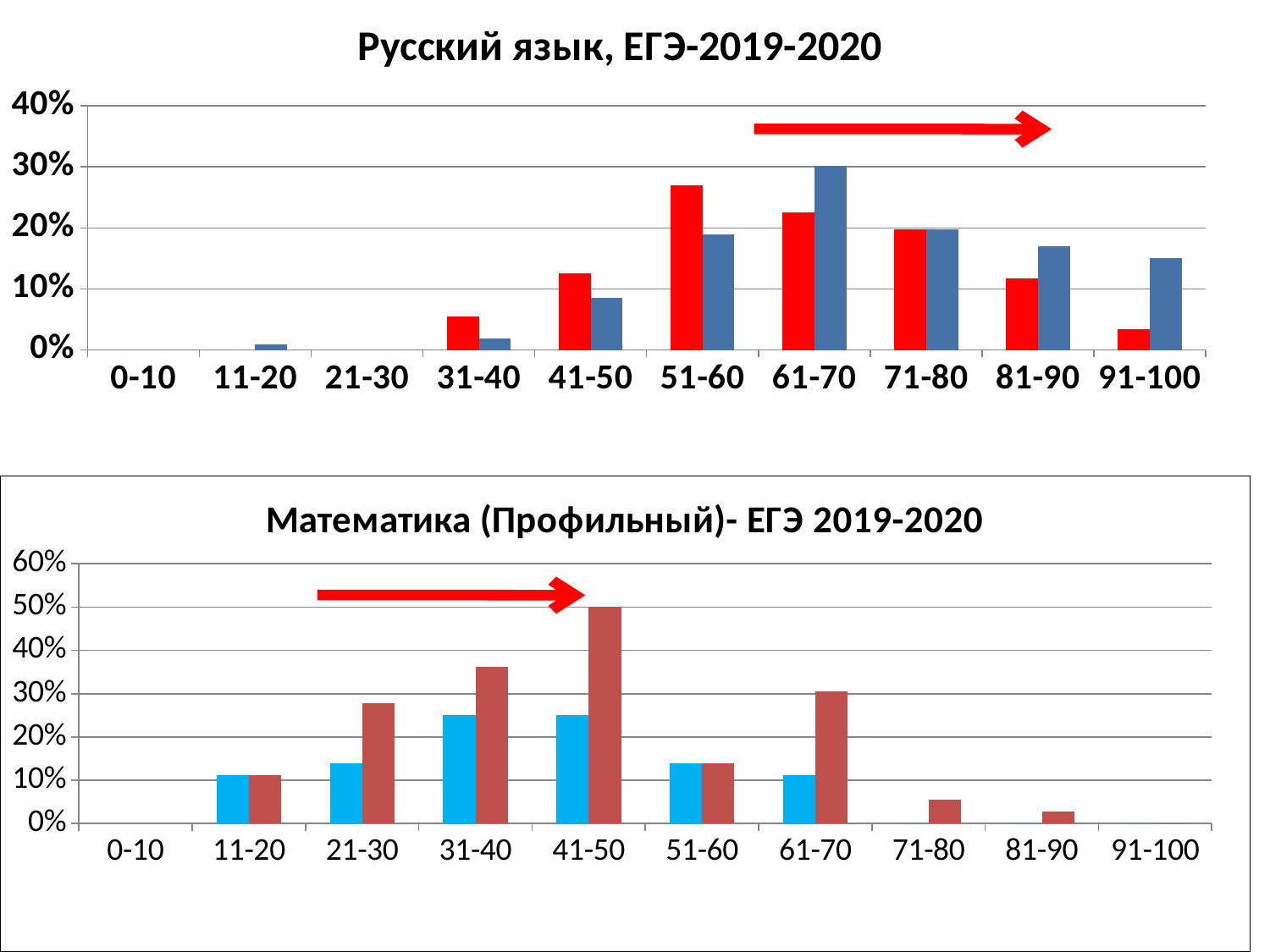
In the top chart "Русский язык, ЕГЭ-2019-2020", for the 91-100 range, which bar is taller, the red or the blue? blue In the bottom chart "Математика (Профильный)- ЕГЭ 2019-2020", which score range has the highest brown bar? 41-50 In the top chart "Русский язык, ЕГЭ-2019-2020", is the blue bar for 61-70 greater or less than 20%? greater In the top chart "Русский язык, ЕГЭ-2019-2020", is the red bar for 51-60 greater or less than 20%? greater In the top chart "Русский язык, ЕГЭ-2019-2020", which score range has the highest blue bar? 61-70 What kind of chart is the top chart titled "Русский язык, ЕГЭ-2019-2020"? bar chart In the bottom chart "Математика (Профильный)- ЕГЭ 2019-2020", for the 31-40 range, which bar is taller, the light blue or the brown? brown In the top chart "Русский язык, ЕГЭ-2019-2020", which score range has the highest red bar? 51-60 What is the title of the bottom chart? Математика (Профильный)- ЕГЭ 2019-2020 In the bottom chart "Математика (Профильный)- ЕГЭ 2019-2020", is the brown bar for 41-50 greater or less than 40%? greater How many score-range categories are shown on the x axis of the top chart "Русский язык, ЕГЭ-2019-2020"? 10